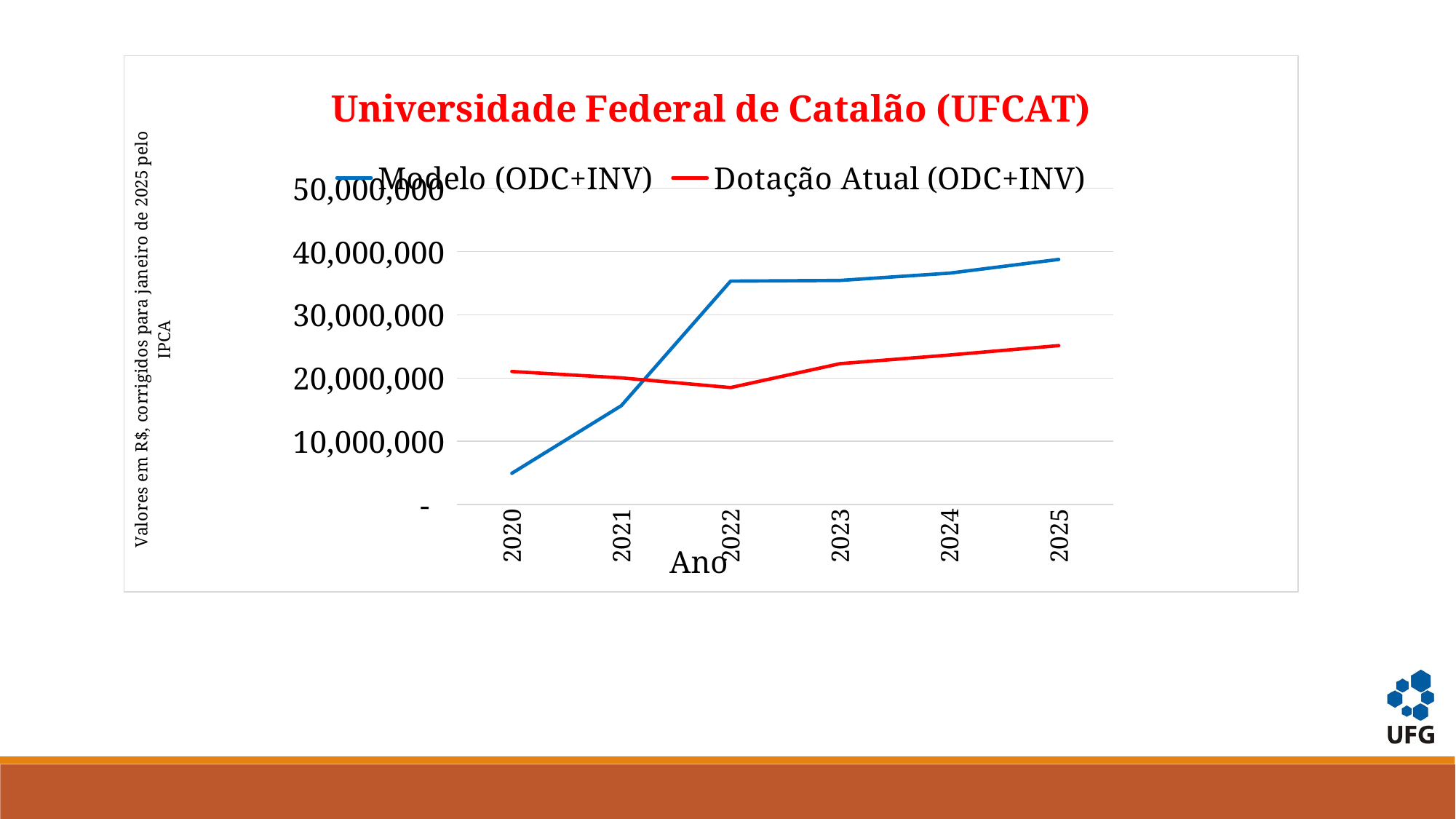
What kind of chart is shown on the slide? line chart What is the label of the x axis? Ano In 2025, which series has the larger value, Modelo (ODC+INV) or Dotação Atual (ODC+INV)? Modelo (ODC+INV) Is the value for Modelo (ODC+INV) in 2022 greater or less than 30,000,000? greater Is the value for Modelo (ODC+INV) in 2020 greater or less than 10,000,000? less How many years are plotted along the x axis? 6 In which year does the Modelo (ODC+INV) series reach its lowest value? 2020 Is the value for Dotação Atual (ODC+INV) in 2022 greater or less than 20,000,000? less What is the title of the chart? Universidade Federal de Catalão (UFCAT) In 2020, which series has the larger value, Modelo (ODC+INV) or Dotação Atual (ODC+INV)? Dotação Atual (ODC+INV) How many series does the legend list? 2